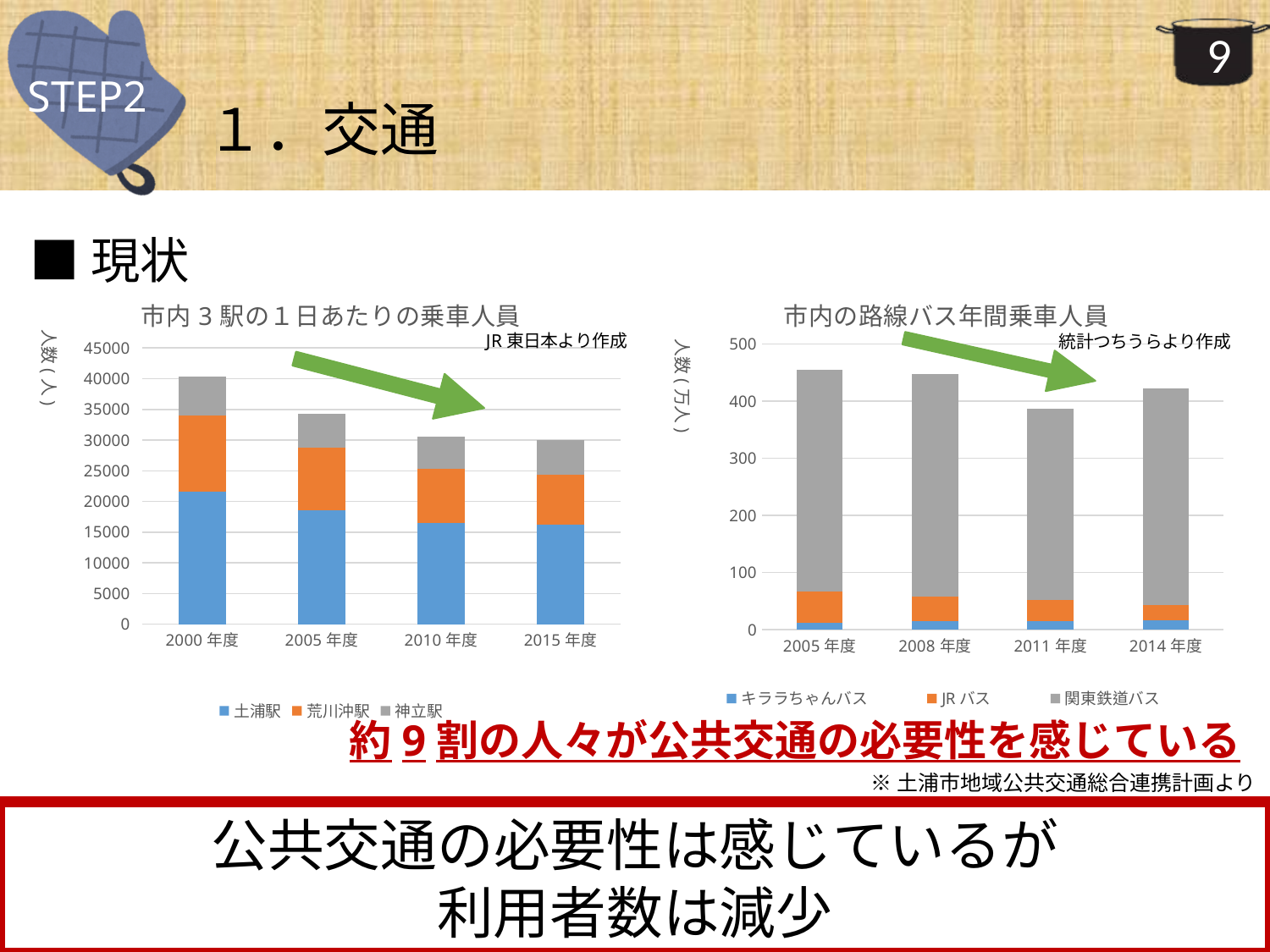
In the left chart (市内３駅の１日あたりの乗車人員), which fiscal year has the highest total bar? 2000年度 In the left chart (市内３駅の１日あたりの乗車人員), is the total for 2000年度 greater or less than 35000? greater In the left chart (市内３駅の１日あたりの乗車人員), is the 土浦駅 segment for 2015年度 greater or less than 20000? less How many fiscal-year categories are shown on the x axis of the left chart (市内３駅の１日あたりの乗車人員)? 4 In the right chart (市内の路線バス年間乗車人員), is the total for 2011年度 greater or less than 400? less In the left chart (市内３駅の１日あたりの乗車人員), do the total bar heights rise or fall from 2000年度 to 2015年度? fall In the right chart (市内の路線バス年間乗車人員), which total bar is larger, 2011年度 or 2014年度? 2014年度 How many series does the legend of the left chart (市内３駅の１日あたりの乗車人員) list? 3 Which series is shown in blue in the left chart (市内３駅の１日あたりの乗車人員)? 土浦駅 How many series does the legend of the right chart (市内の路線バス年間乗車人員) list? 3 What kind of chart is the left chart titled 市内３駅の１日あたりの乗車人員? stacked bar chart In the right chart (市内の路線バス年間乗車人員), which fiscal year has the lowest total bar? 2011年度